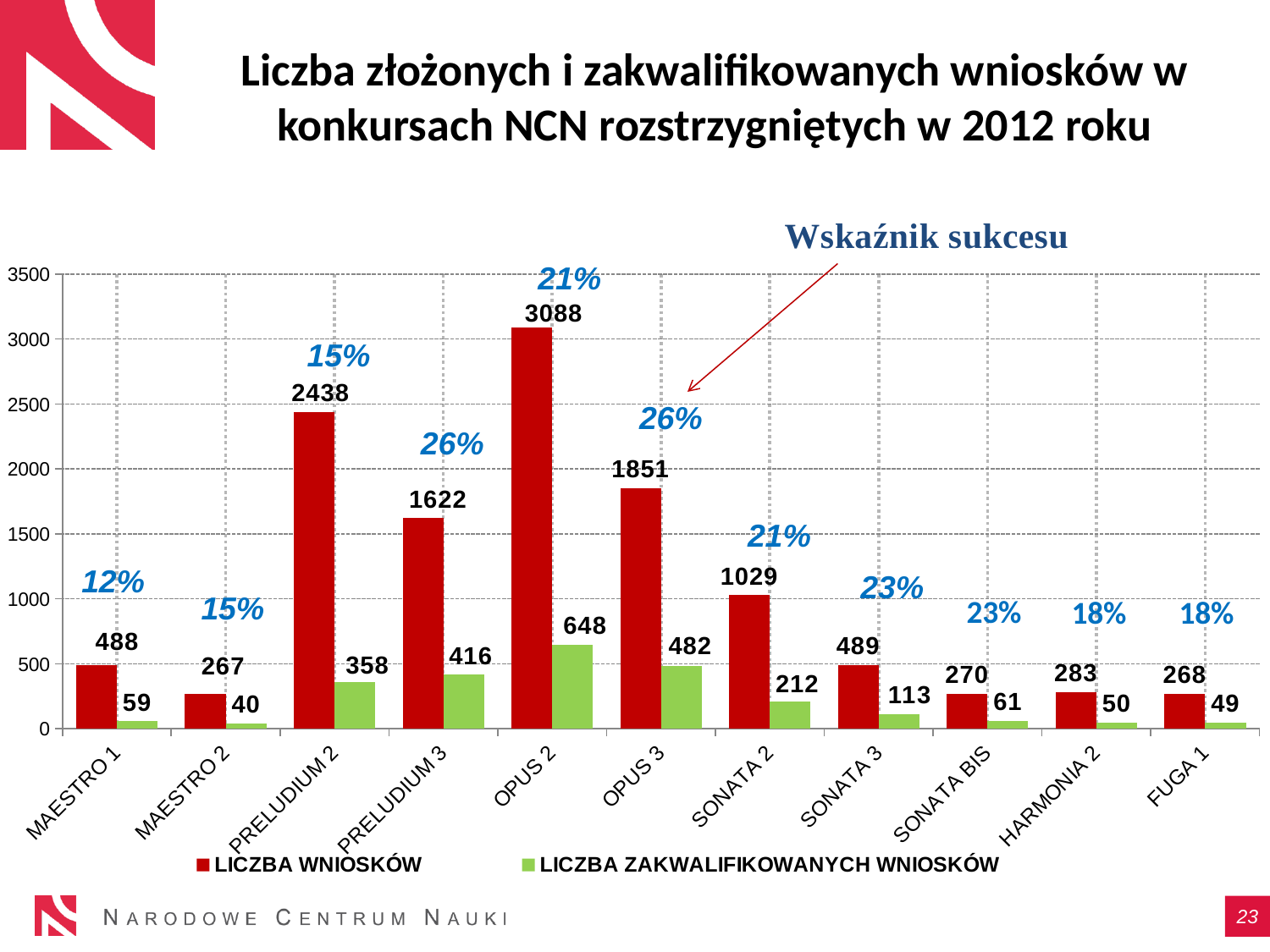
How many series does the legend list? 2 What is the value of LICZBA WNIOSKÓW for OPUS 2? 3088 How many categories are shown on the x axis? 11 What colour are the LICZBA ZAKWALIFIKOWANYCH WNIOSKÓW bars? green What success rate (wskaźnik sukcesu) is shown above the OPUS 3 bars? 26% What is the difference between LICZBA WNIOSKÓW for PRELUDIUM 2 and PRELUDIUM 3? 816 What kind of chart is shown on the slide? bar chart Which is larger: LICZBA ZAKWALIFIKOWANYCH WNIOSKÓW for OPUS 2 or for OPUS 3? OPUS 2 Is the value of LICZBA WNIOSKÓW for SONATA 2 greater or less than 1000? greater What is the value of LICZBA ZAKWALIFIKOWANYCH WNIOSKÓW for PRELUDIUM 3? 416 Which category has the highest LICZBA WNIOSKÓW? OPUS 2 Which category has the lowest LICZBA ZAKWALIFIKOWANYCH WNIOSKÓW? MAESTRO 2